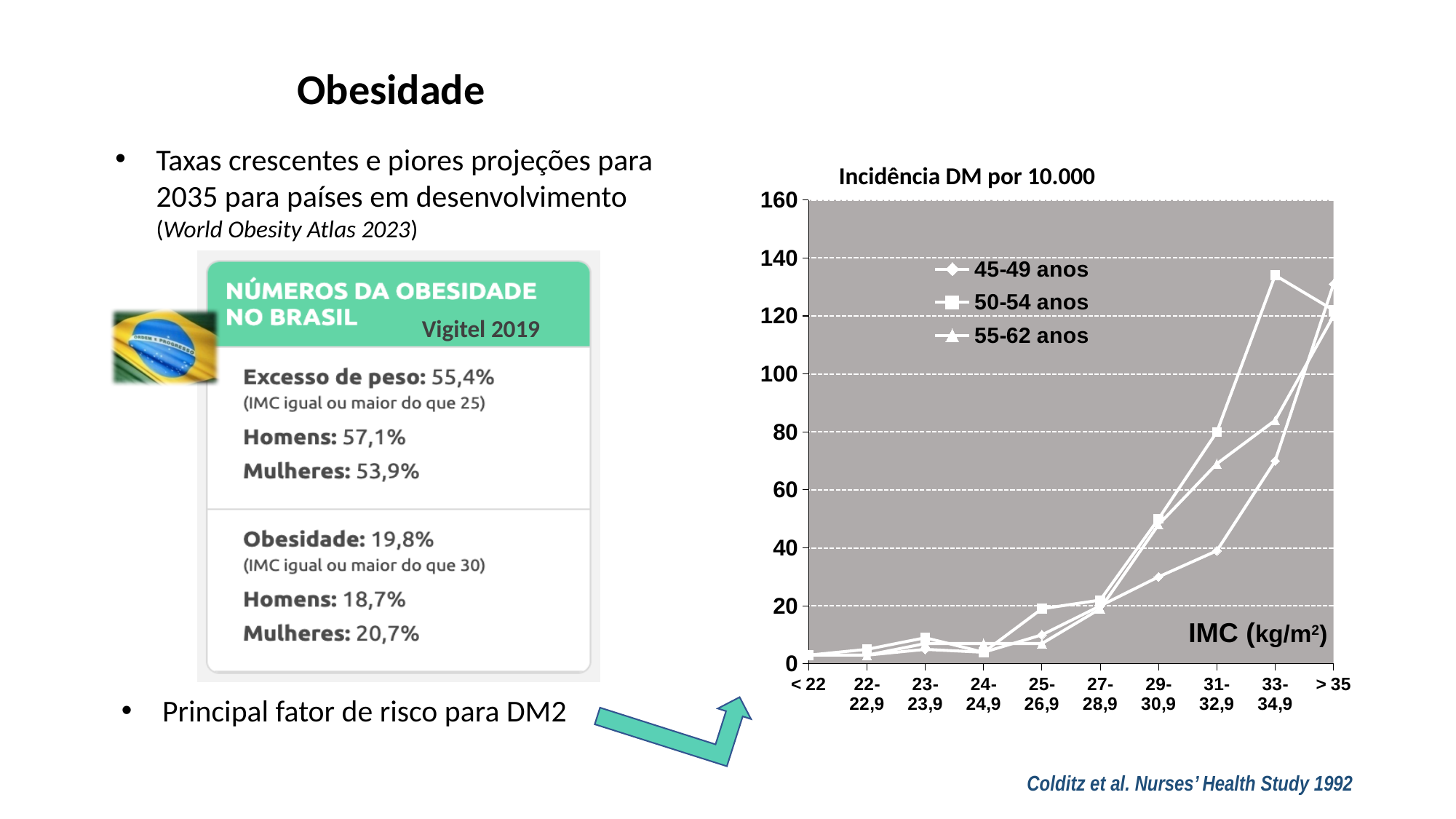
In the 'Incidência DM por 10.000' chart, at which IMC category does the 45-49 anos series have its lowest value? < 22 and 22-22,9 (tied) What is the title of the chart on the right side of the slide? Incidência DM por 10.000 In the 'Incidência DM por 10.000' chart, at which IMC category does the 50-54 anos series reach its highest value? 33-34,9 In the 'Incidência DM por 10.000' chart, at IMC 33-34,9, which series has the larger value: 50-54 anos or 45-49 anos? 50-54 anos What kind of chart is shown on the right side of the slide? line chart In the 'Incidência DM por 10.000' chart, is the value for the 55-62 anos series at IMC 31-32,9 greater or less than 60? greater In the 'Incidência DM por 10.000' chart, is the value for the 45-49 anos series at IMC 29-30,9 greater or less than 40? less In the 'Incidência DM por 10.000' chart, is the value for the 50-54 anos series at IMC 33-34,9 greater or less than 120? greater How many series does the legend of the 'Incidência DM por 10.000' chart list? 3 In the 'Incidência DM por 10.000' chart, at IMC 31-32,9, which series has the larger value: 45-49 anos or 50-54 anos? 50-54 anos How many IMC categories are shown on the x axis of the 'Incidência DM por 10.000' chart? 10 In the 'Incidência DM por 10.000' chart, do the values generally rise or fall as IMC increases along the x axis? rise